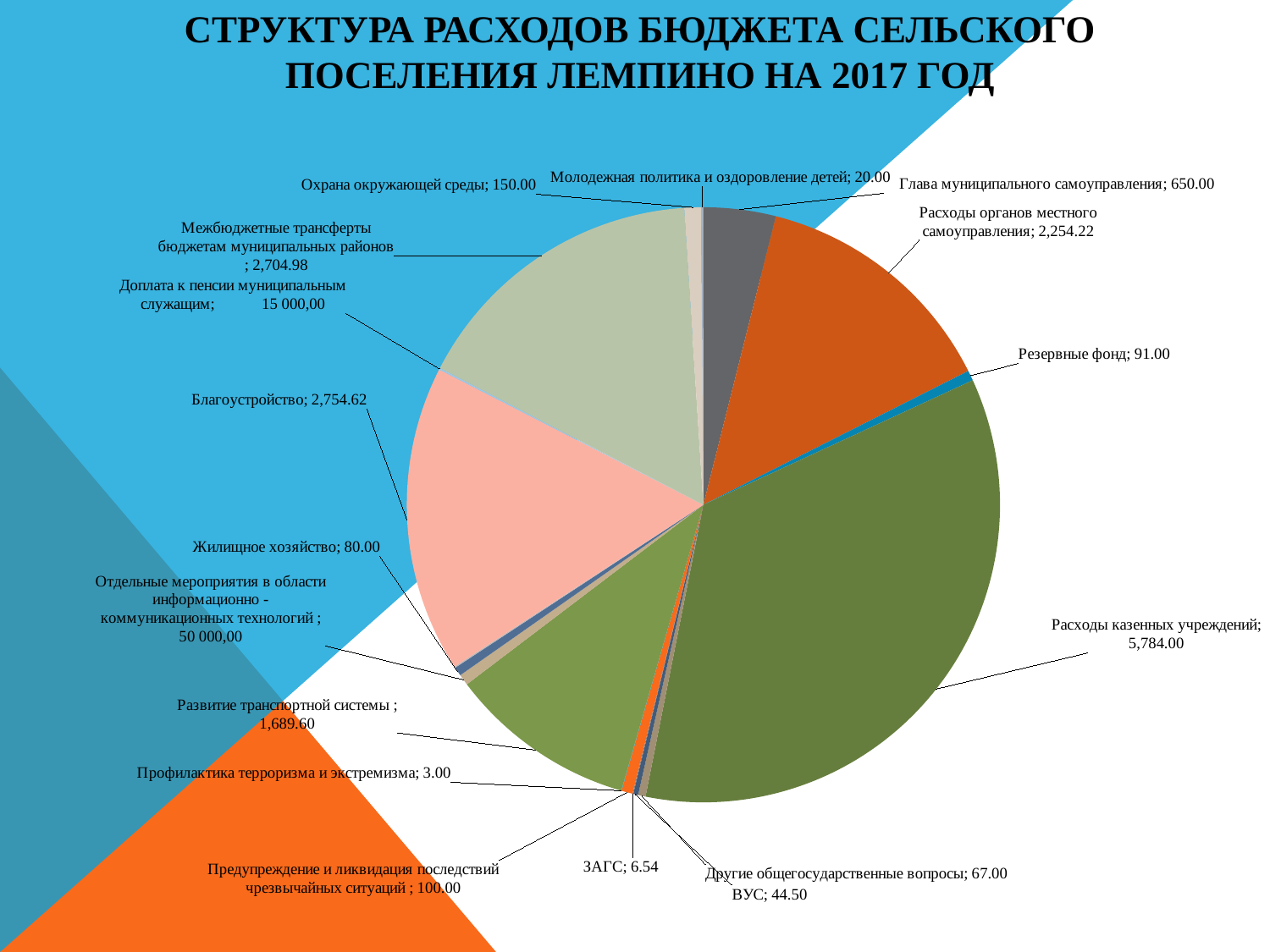
What kind of chart is shown on the slide? pie chart What is the difference between the values for Глава муниципального самоуправления and Охрана окружающей среды? 500.00 What is the difference between the values for Благоустройство and Межбюджетные трансферты бюджетам муниципальных районов? 49.64 What is the title of the slide? СТРУКТУРА РАСХОДОВ БЮДЖЕТА СЕЛЬСКОГО ПОСЕЛЕНИЯ ЛЕМПИНО НА 2017 ГОД What is the value for Охрана окружающей среды? 150.00 Which category has the largest slice of the pie? Расходы казенных учреждений Which is larger: Расходы органов местного самоуправления or Развитие транспортной системы? Расходы органов местного самоуправления What is the value for Благоустройство? 2,754.62 What is the value for ЗАГС? 6.54 What is the value for Расходы казенных учреждений? 5,784.00 What is the value for Развитие транспортной системы? 1,689.60